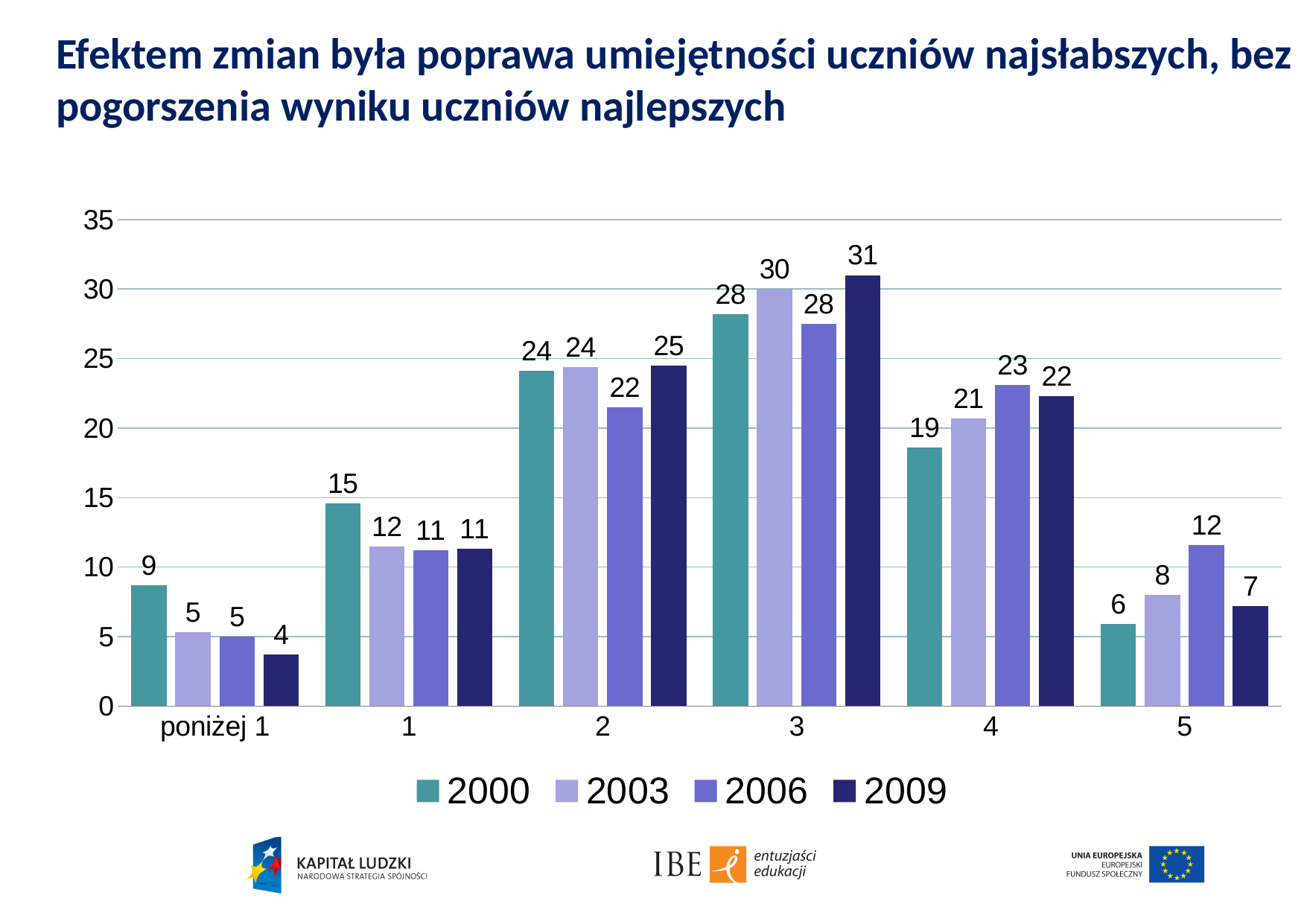
Which series is shown in the darkest navy colour in the legend? 2009 What is the value for category 5 in the 2006 series? 12 What is the value for category 'poniżej 1' in the 2000 series? 9 What is the value for category 3 in the 2009 series? 31 Which category has the lowest value in the 2009 series? poniżej 1 How many categories are shown on the x axis? 6 What is the difference between the 2000 and 2009 values for category 'poniżej 1'? 5 Which category has the highest value in the 2003 series? 3 What is the difference between the 2009 and 2000 values for category 3? 3 Which is larger for category 4: the 2000 value or the 2006 value? 2006 How many series does the legend list? 4 What kind of chart is shown on the slide? bar chart